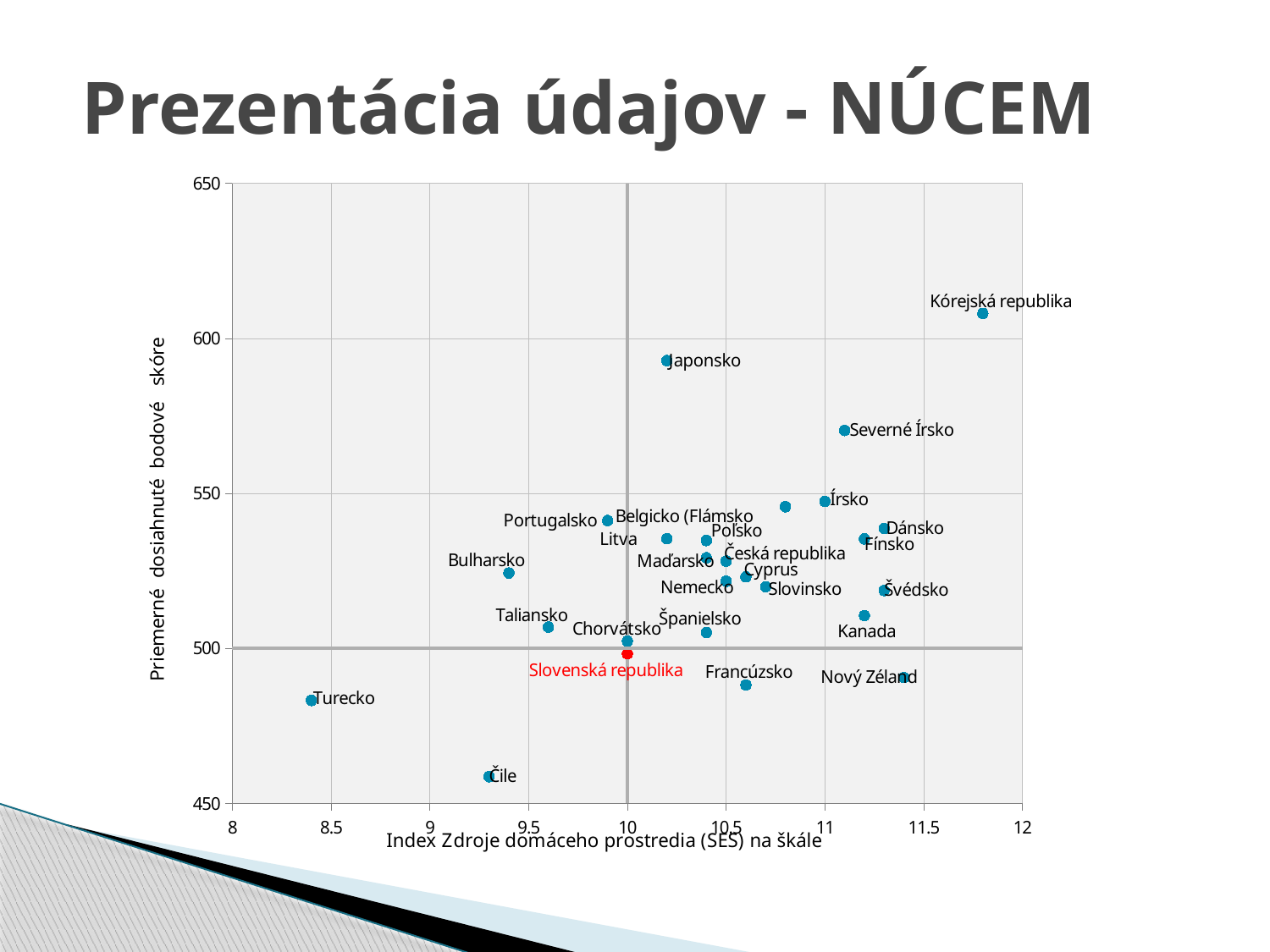
What kind of chart is shown on the slide? scatter chart Which country has the lowest SES index value on the x axis? Turecko Which country has the lowest average score? Čile Is the average score for Japonsko greater or less than 550? greater Which country's point is shown in red on the chart? Slovenská republika Is the SES index for Kórejská republika greater or less than 11.5? greater What is the title of the x axis? Index Zdroje domáceho prostredia (SES) na škále Which has the higher average score, Japonsko or Severné Írsko? Japonsko Is the average score for Turecko greater or less than 500? less Which country has the highest average score (Priemerné dosiahnuté bodové skóre)? Kórejská republika